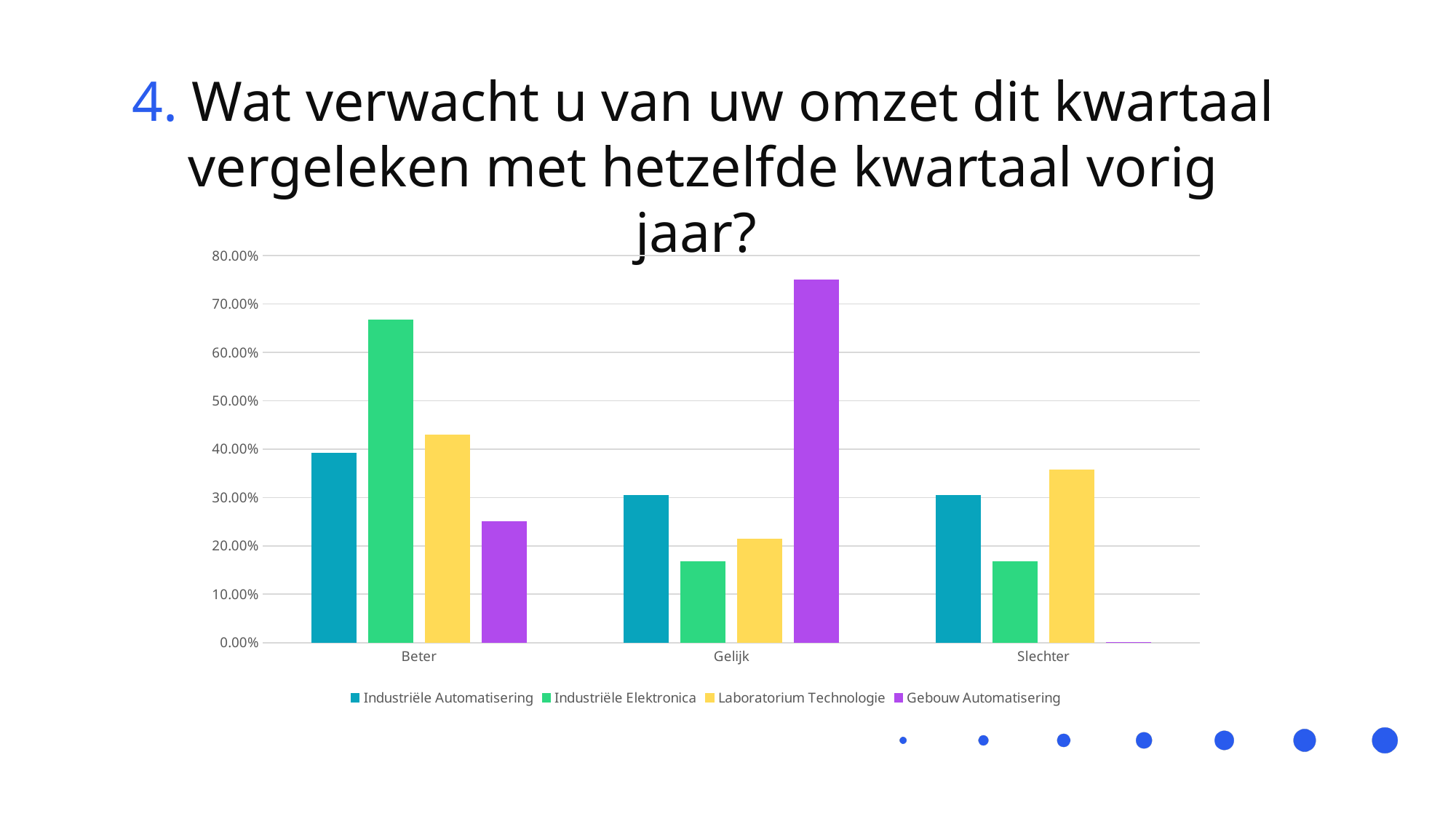
How many categories are shown on the x axis? 3 Which is larger: Laboratorium Technologie in the Beter category or Laboratorium Technologie in the Gelijk category? Beter Which series has the highest value in the Beter category? Industriële Elektronica How many series does the legend list? 4 Which series has the lowest value in the Beter category? Gebouw Automatisering Which series has the highest value in the Gelijk category? Gebouw Automatisering What kind of chart is shown on the slide? bar chart Is the value for Gebouw Automatisering in the Gelijk category greater or less than 70.00%? greater Which series has the lowest value in the Slechter category? Gebouw Automatisering Is the value for Industriële Elektronica in the Slechter category greater or less than 20.00%? less Is the value for Industriële Elektronica in the Beter category greater or less than 60.00%? greater Which colour represents Gebouw Automatisering in the legend? purple